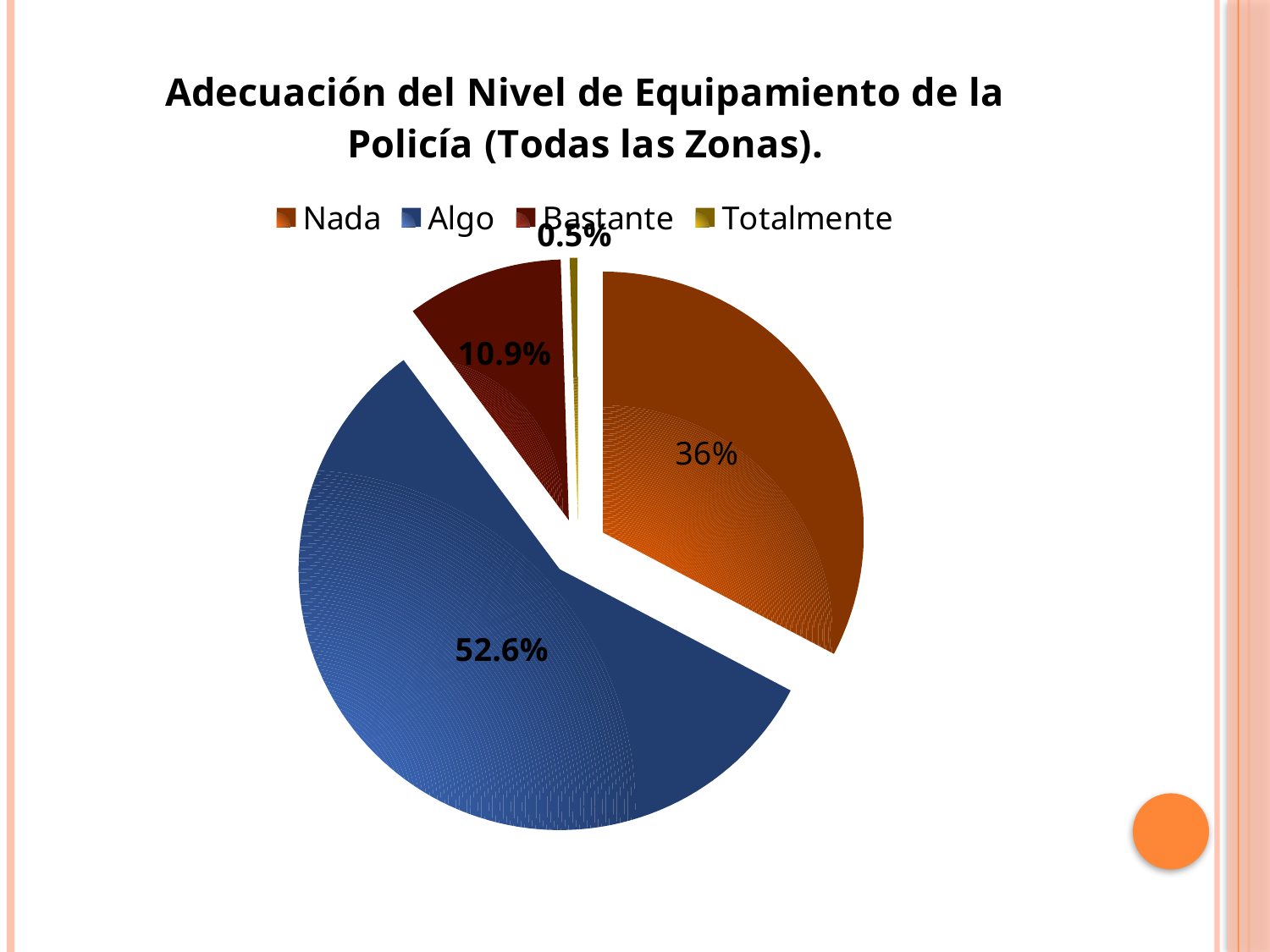
What is the title of the chart? Adecuación del Nivel de Equipamiento de la Policía (Todas las Zonas). What type of chart is shown on the slide? pie chart Which category has the largest slice of the pie? Algo What percentage is shown for the Bastante slice? 10.9% What colour is the Algo slice? blue What percentage is shown for the Totalmente slice? 0.5% Which is larger, the Nada slice or the Bastante slice? Nada Which category has the smallest slice of the pie? Totalmente How many categories does the legend list? 4 What percentage is shown for the Algo slice? 52.6% What is the difference in percentage points between the Algo slice and the Nada slice? 16.6 What percentage is shown for the Nada slice? 36%